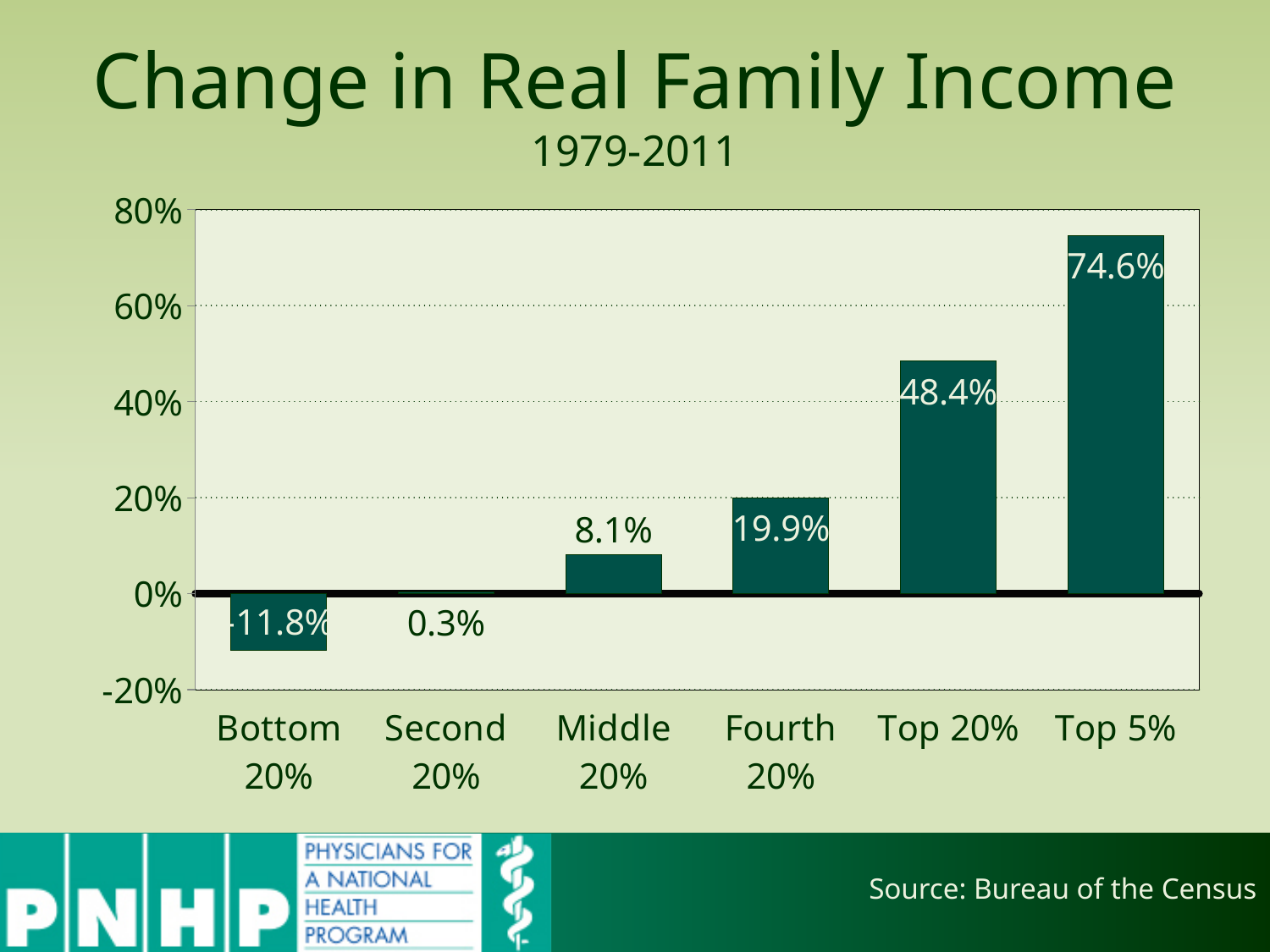
What is the difference between the change for the Top 5% and the Top 20%? 26.2% Which category has the highest change in real family income? Top 5% What is the change in real family income for the Fourth 20%? 19.9% What is the change in real family income for the Middle 20%? 8.1% What is the change in real family income for the Top 5%? 74.6% Which is larger, the change for the Second 20% or the Middle 20%? Middle 20% Do the values rise or fall moving from the Bottom 20% to the Top 5%? Rise What is the change in real family income for the Bottom 20%? -11.8% Which category has the lowest change in real family income? Bottom 20% How many income categories are shown on the chart? 6 What kind of chart is shown on the slide? Bar chart Is the value for Top 20% greater or less than 40%? greater